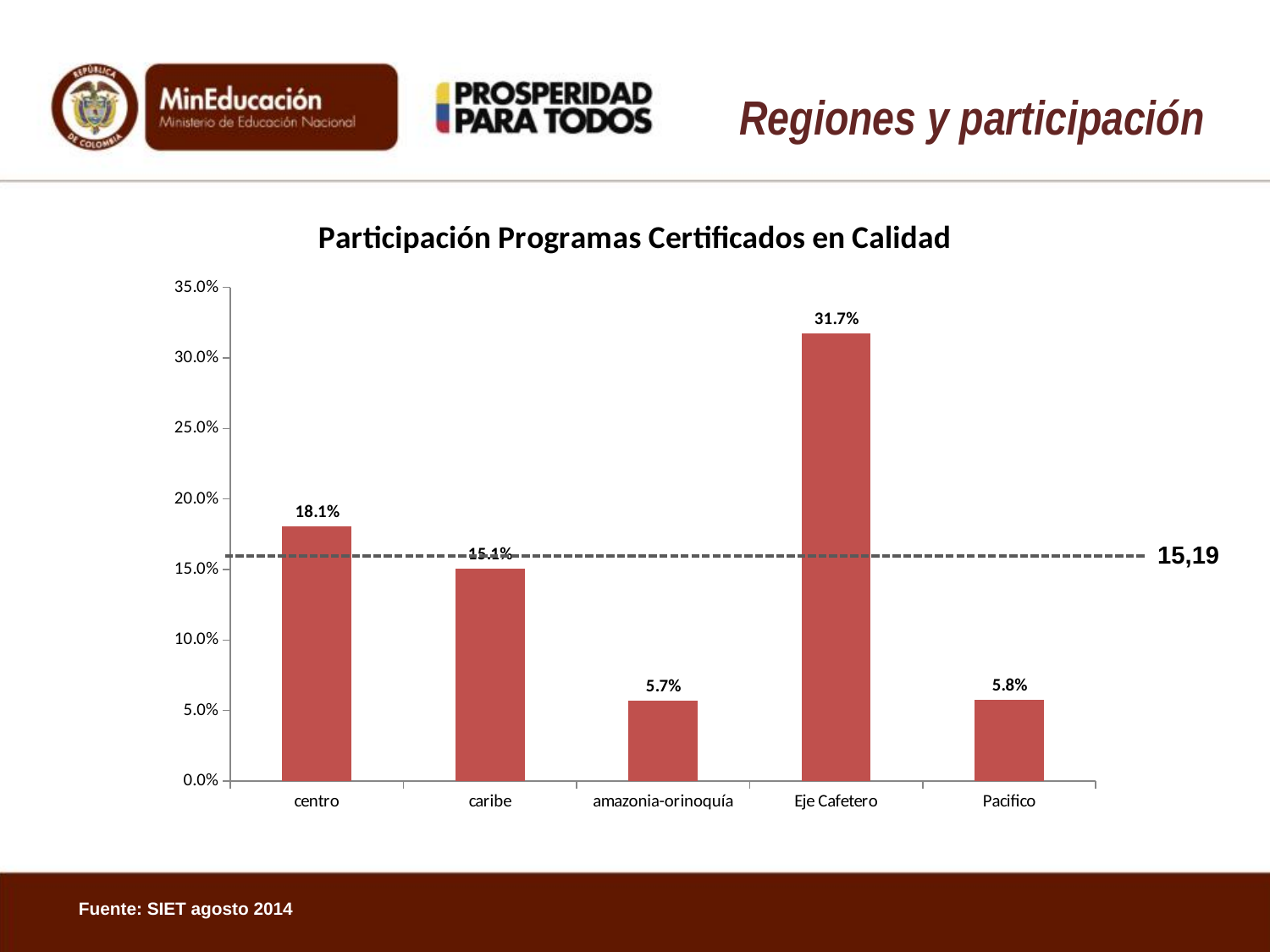
How many regions are shown on the x axis of the chart? 5 What is the value for Pacifico? 5.8% What value is labelled on the dashed horizontal reference line? 15,19 What is the difference between the values for Eje Cafetero and centro? 13.6% What type of chart is shown on the slide? bar chart What is the value for Eje Cafetero? 31.7% What is the value for centro? 18.1% What is the value for amazonia-orinoquía? 5.7% Is the value for caribe greater or less than 10.0%? greater Which is larger, the value for centro or the value for Eje Cafetero? Eje Cafetero Which region has the highest value? Eje Cafetero What is the title of the chart? Participación Programas Certificados en Calidad